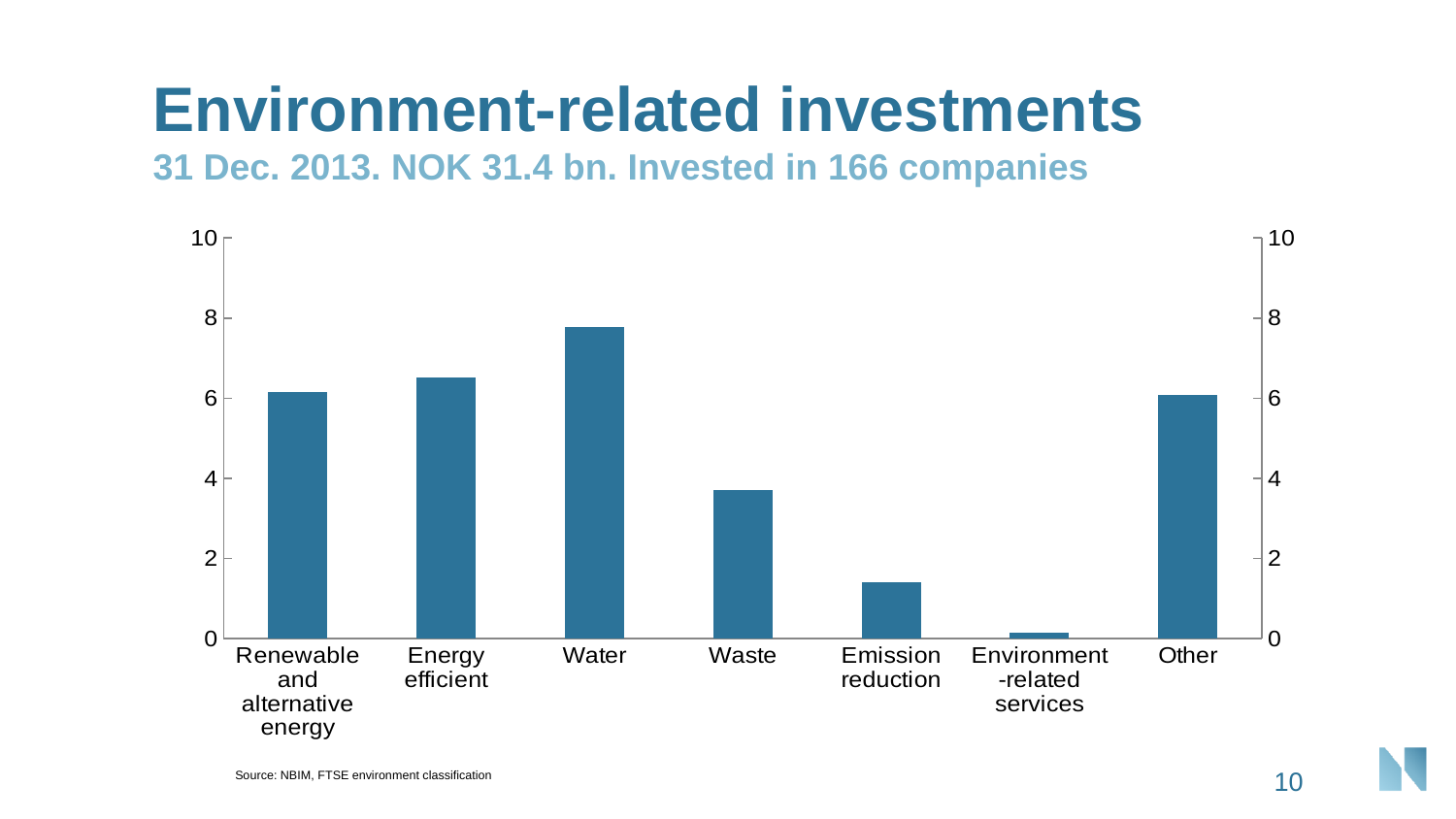
Which category has the lowest bar in the chart? Environment-related services Is the value for Other greater or less than 4? greater Which is larger, the value for Water or the value for Waste? Water What is the title of the chart on the slide? Environment-related investments What is the maximum value shown on the chart's y axis? 10 Is the value for Waste greater or less than 4? less What kind of chart is shown on the slide? Bar chart How many categories are shown on the x axis of the chart? 7 Which category has the highest bar in the chart? Water Is the value for Emission reduction greater or less than 2? less Which is larger, the value for Energy efficient or the value for Emission reduction? Energy efficient